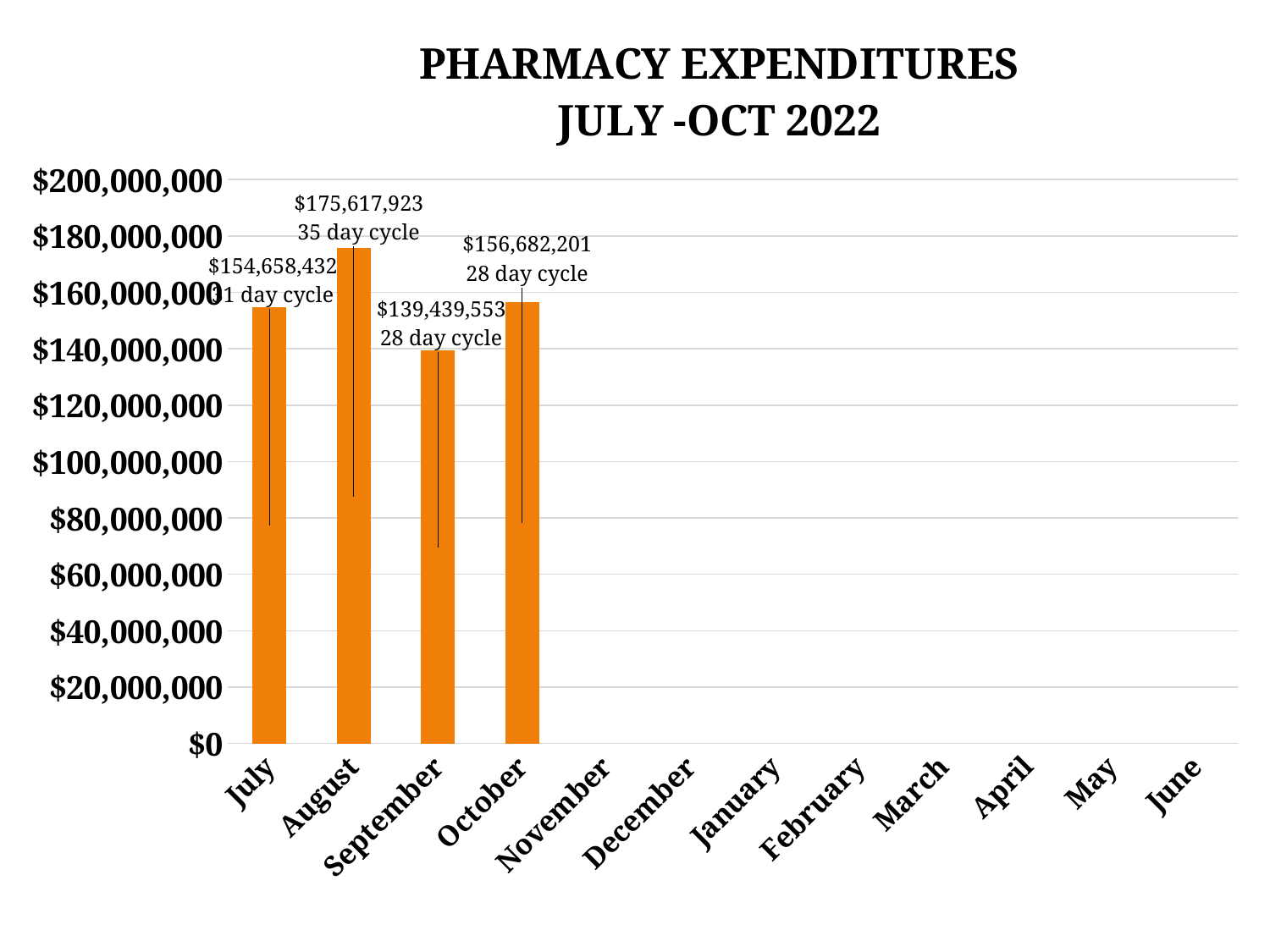
How many months have a bar plotted on the chart? 4 How many days is the billing cycle noted for August? 35 day cycle What is the pharmacy expenditure for September? $139,439,553 What kind of chart is shown on the slide? Bar chart Is the expenditure for September greater or less than $140,000,000? less What is the title of the chart? PHARMACY EXPENDITURES JULY -OCT 2022 What is the pharmacy expenditure for July? $154,658,432 What is the difference between the August and September expenditures? $36,178,370 What is the pharmacy expenditure for October? $156,682,201 Which month has the highest pharmacy expenditure? August Which month has the lowest pharmacy expenditure among the plotted months? September What is the pharmacy expenditure for August? $175,617,923